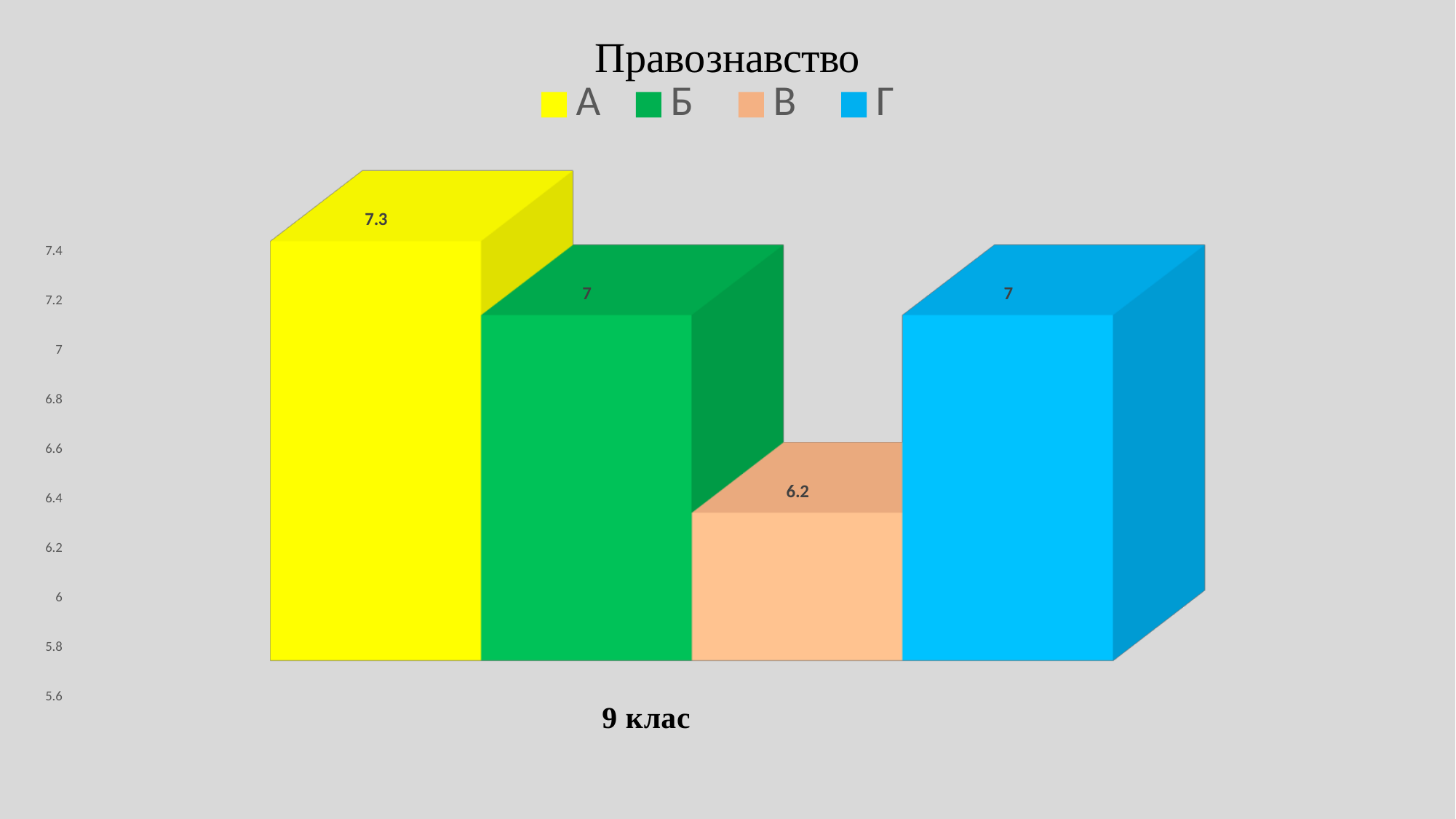
Which series has the lowest value in the Правознавство chart? В Which series has the highest value in the Правознавство chart? А What is the value for series А in the Правознавство chart? 7.3 How many series does the legend of the Правознавство chart list? 4 What is the value for series В in the Правознавство chart? 6.2 Is the value for В in the Правознавство chart greater or less than 6.4? less Which is larger in the Правознавство chart, the value for Б or the value for В? Б What is the difference between the values for А and Г in the Правознавство chart? 0.3 What is the category label shown on the x axis of the Правознавство chart? 9 клас What kind of chart is shown on the slide? bar chart What is the value for series Б in the Правознавство chart? 7 What is the difference between the values for А and В in the Правознавство chart? 1.1